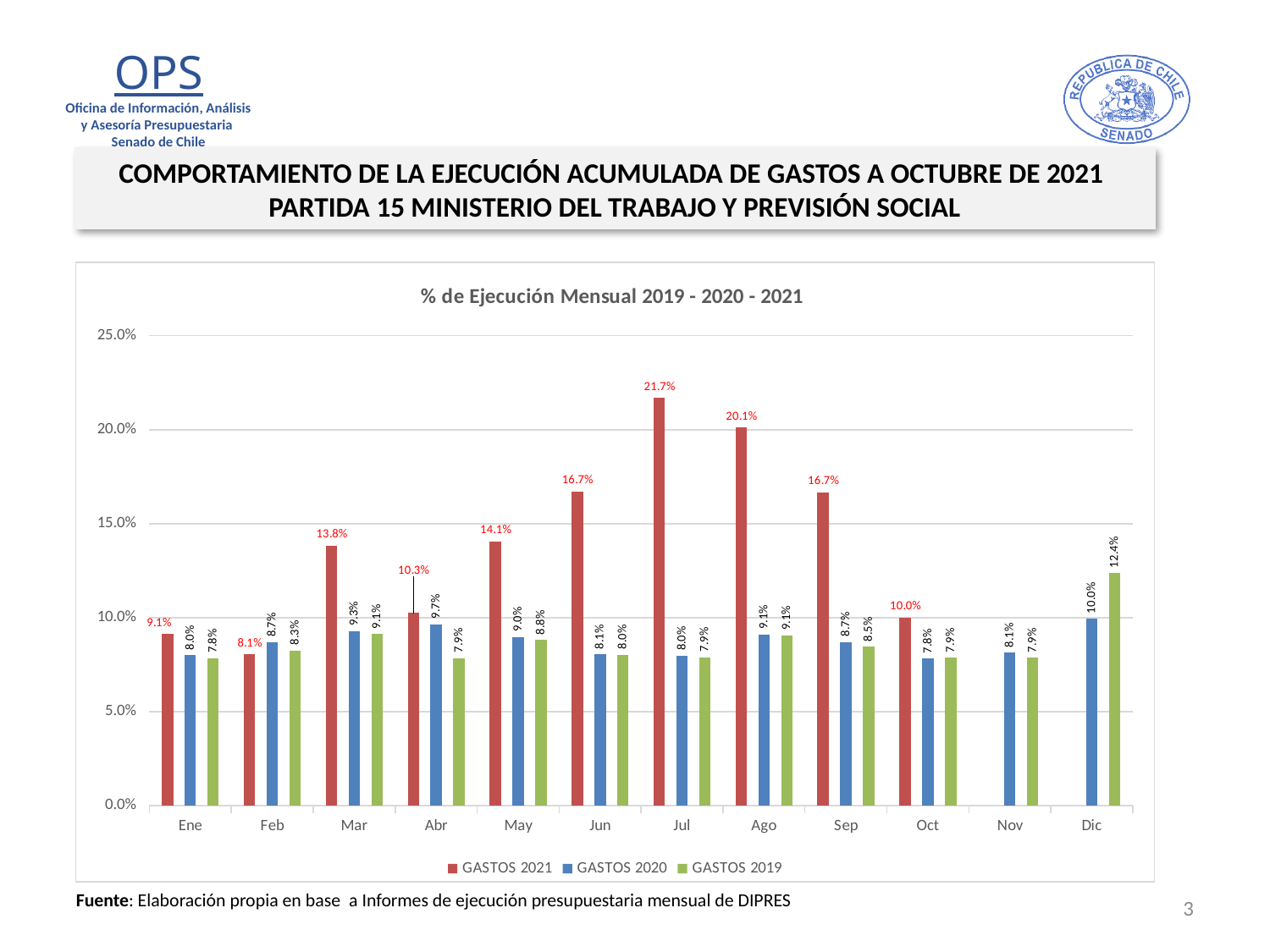
Does the GASTOS 2021 series rise or fall from Sep to Oct? fall What is the value for GASTOS 2021 in Jul? 21.7% How many months are shown on the x axis? 12 How many series does the legend list? 3 What is the difference between GASTOS 2021 and GASTOS 2020 in Ago? 11.0% In which month is the GASTOS 2021 value highest? Jul In which month is the GASTOS 2020 value lowest? Oct What is the value for GASTOS 2020 in Abr? 9.7% Which is larger in Feb: GASTOS 2021 or GASTOS 2020? GASTOS 2020 What is the title of the chart? % de Ejecución Mensual 2019 - 2020 - 2021 What type of chart is shown on the slide? bar chart What is the value for GASTOS 2019 in Dic? 12.4%